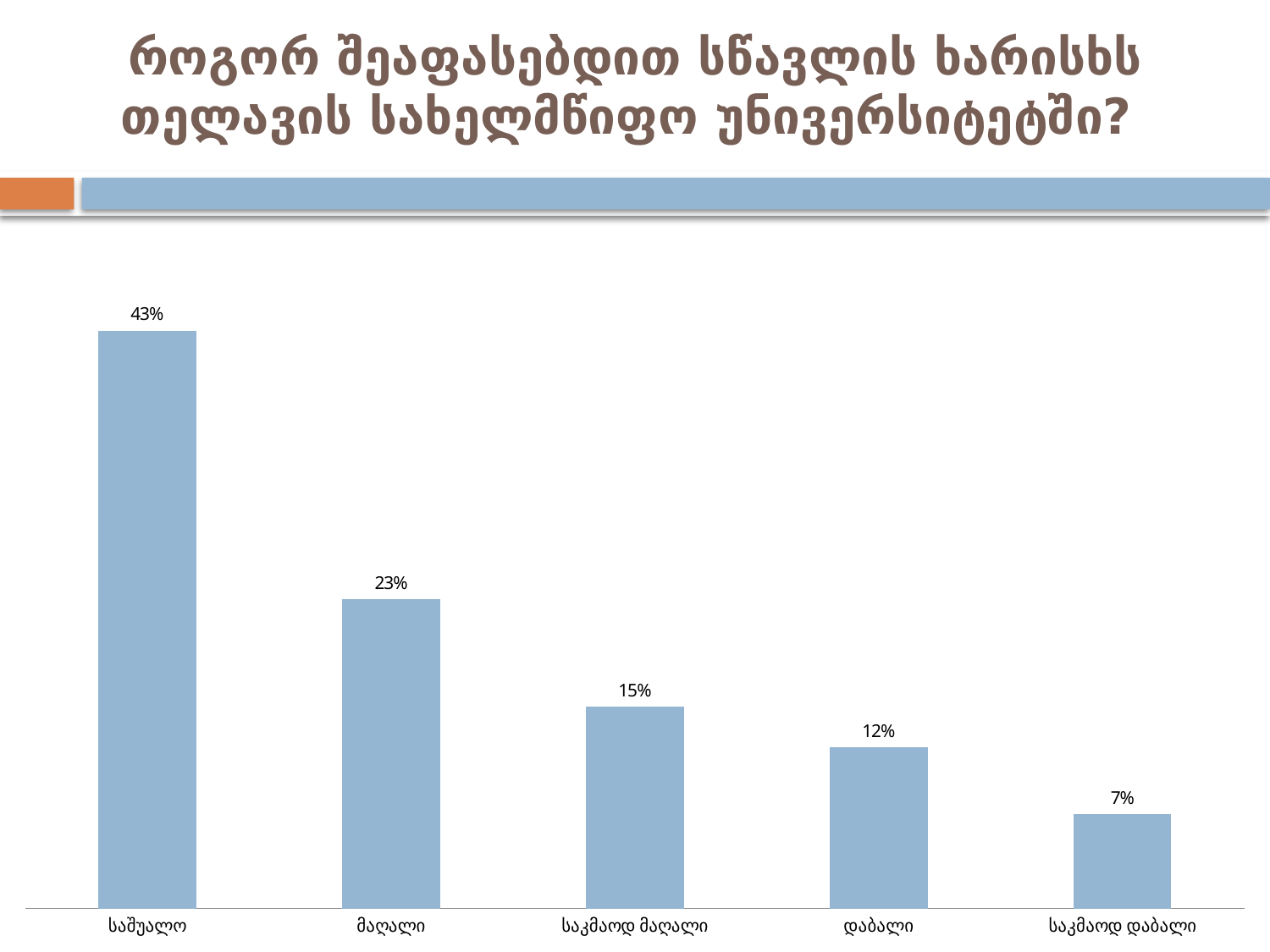
How many categories are shown on the chart? 5 Which category has the lowest value? საკმაოდ დაბალი What is the value for საკმაოდ მაღალი? 15% What kind of chart is shown on the slide? bar chart What is the value for საკმაოდ დაბალი? 7% Which category has the highest value? საშუალო What is the difference between the values for საშუალო and მაღალი? 20% What is the value for მაღალი? 23% Which is larger, the value for დაბალი or the value for საკმაოდ დაბალი? დაბალი What is the value for დაბალი? 12% Do the values rise or fall from left to right along the x axis? fall What is the value for საშუალო? 43%